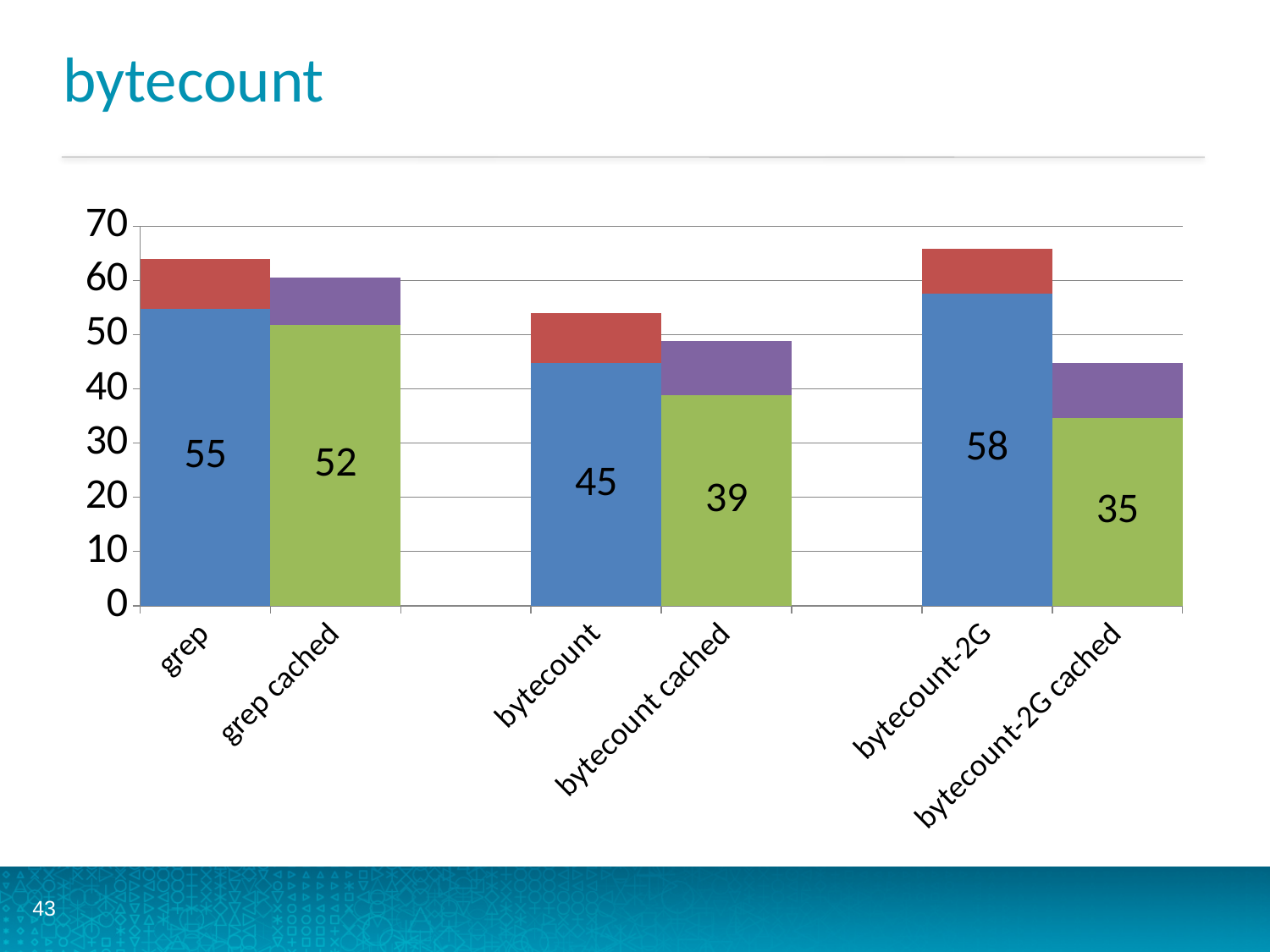
What is the labelled value of the bottom segment for the bytecount cached bar? 39 Which has the larger labelled value, bytecount or bytecount cached? bytecount Which category has the lowest labelled bottom-segment value? bytecount-2G cached Is the total height of the grep bar greater or less than 60? greater What is the difference between the labelled values for bytecount-2G (58) and bytecount-2G cached (35)? 23 What is the labelled value of the bottom segment for the bytecount-2G bar? 58 What type of chart is shown on the slide? Stacked bar chart What is the labelled value of the bottom segment for the bytecount-2G cached bar? 35 What is the labelled value of the bottom segment for the grep bar? 55 What is the difference between the labelled values for grep (55) and grep cached (52)? 3 How many categories are shown on the x axis? 6 Which category has the highest labelled bottom-segment value? bytecount-2G